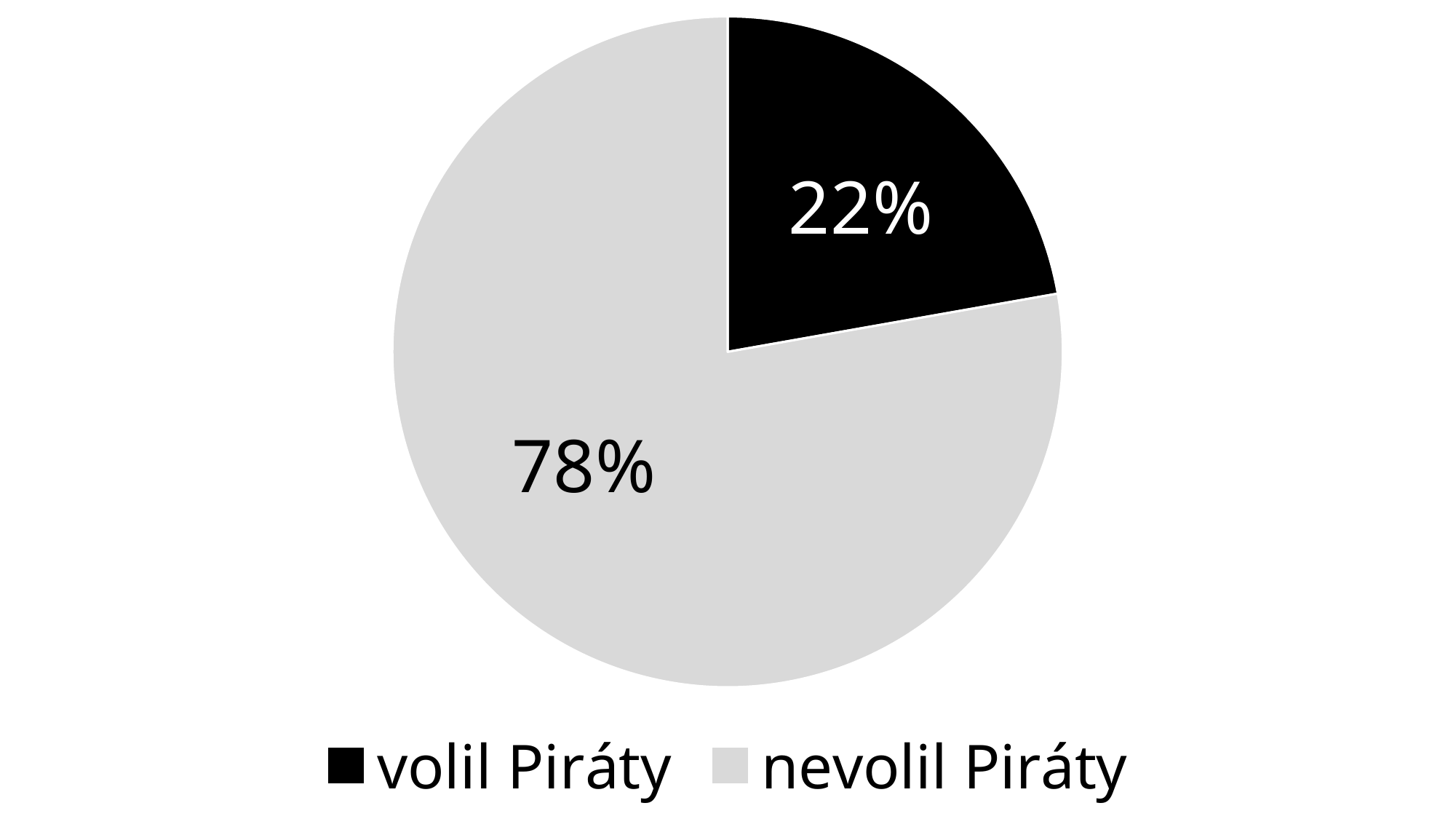
Which is larger, the "volil Piráty" slice or the "nevolil Piráty" slice? nevolil Piráty What kind of chart is shown on the slide? pie chart What is the difference in percentage points between the "nevolil Piráty" and "volil Piráty" slices? 56 How many entries does the legend list? 2 What colour is the "nevolil Piráty" slice? light grey Which slice of the pie is the smallest? volil Piráty What colour is the "volil Piráty" slice? black Which slice of the pie is the largest? nevolil Piráty What share of the pie is labelled "volil Piráty"? 22% How many slices does the pie chart have? 2 What share of the pie is labelled "nevolil Piráty"? 78%